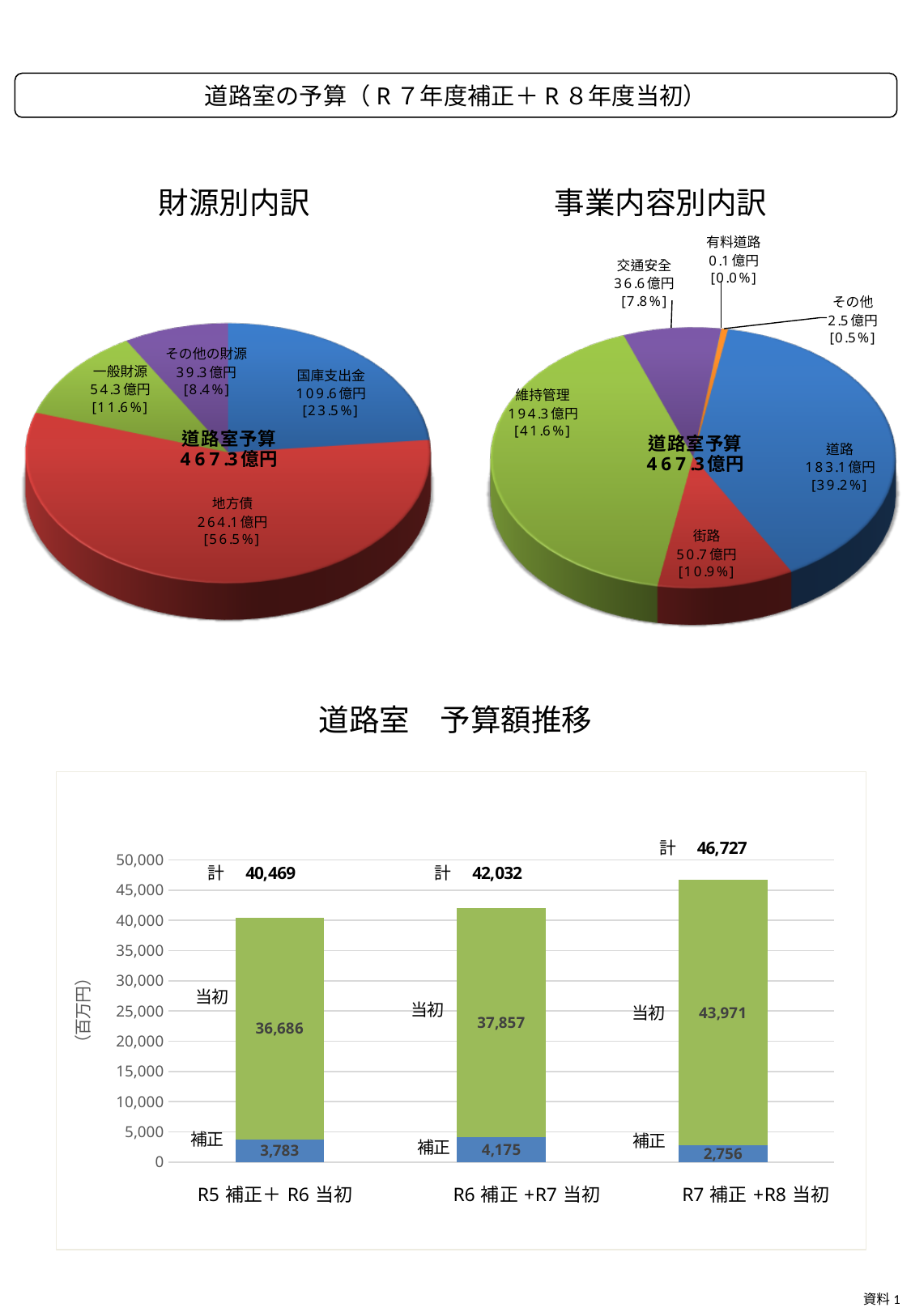
In the 道路室 予算額推移 bar chart, what is the total (計) of the R6 補正+R7 当初 bar? 42,032 In the 事業内容別内訳 pie chart, which category is the largest? 維持管理 In the 財源別内訳 pie chart, what is the value for 地方債? 264.1億円 In the 事業内容別内訳 pie chart, what is the value for 維持管理? 194.3億円 In the 道路室 予算額推移 bar chart, which is larger, the 補正 value for R5 補正+R6 当初 or for R7 補正+R8 当初? R5 補正+R6 当初 In the 財源別内訳 pie chart, how many categories are shown? 4 In the 財源別内訳 pie chart, which category is the smallest? その他の財源 In the 道路室 予算額推移 bar chart, what is the 当初 value for R7 補正+R8 当初? 43,971 In the 財源別内訳 pie chart, what share of the total does 国庫支出金 represent? 23.5% In the 事業内容別内訳 pie chart, what is the difference between 道路 and 街路? 132.4億円 In the 事業内容別内訳 pie chart, what share of the total does 交通安全 represent? 7.8% What kind of chart is 道路室 予算額推移? Stacked bar chart